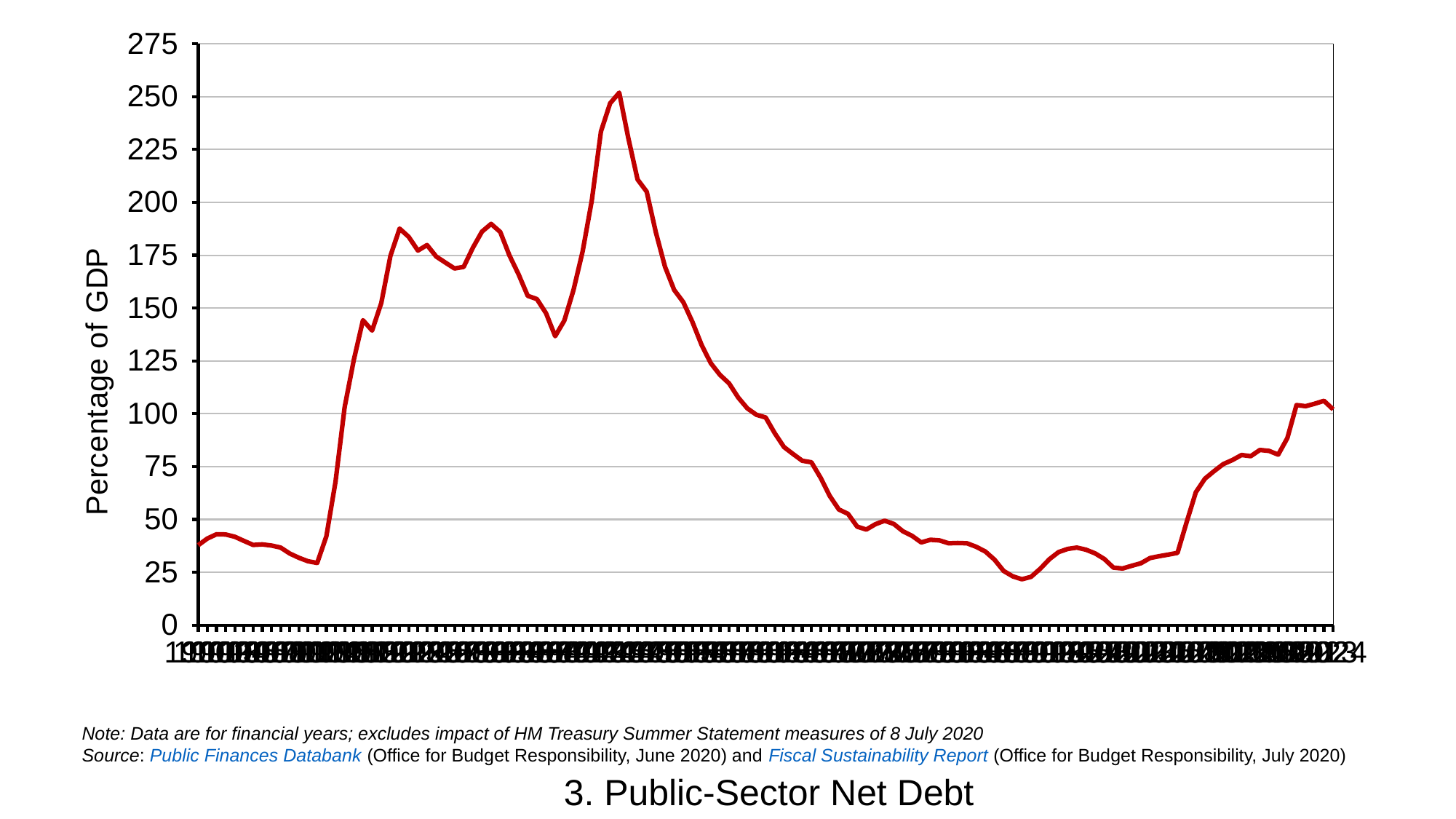
How many data series are plotted on the chart? 1 Is the lowest value reached by the line greater or less than 50? less Is the value at the far right end of the line greater or less than 75? greater Is the value at the far right end of the line greater or less than the value at the far left start of the line? greater Is the value at the far left start of the line greater or less than 50? less Does the line rise or fall over the final portion of the x axis, at the right-hand end of the chart? rise What is the label on the vertical axis of the chart? Percentage of GDP What kind of chart is shown on the slide? line chart What is the title of the chart? 3. Public-Sector Net Debt